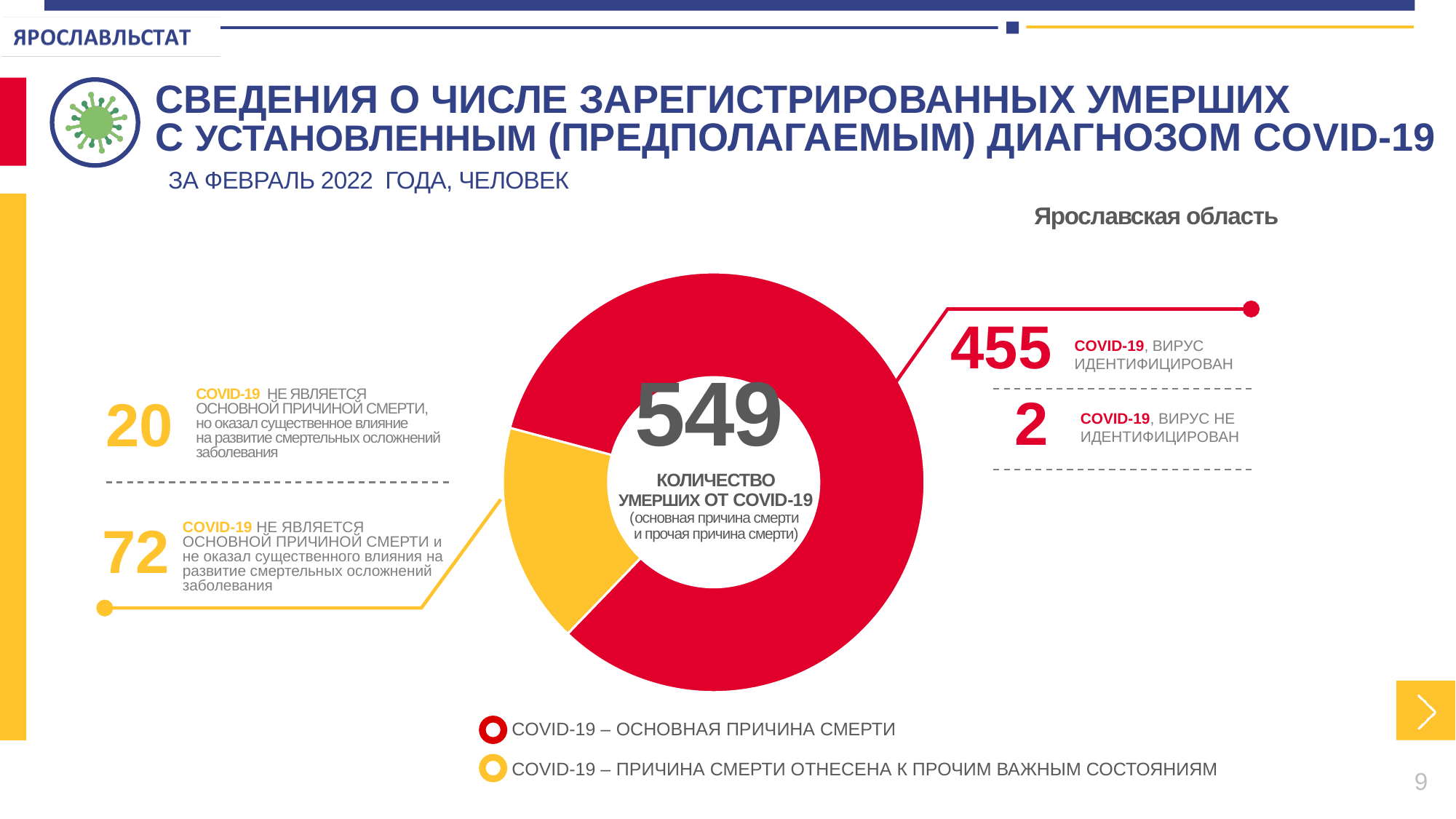
How many deaths are shown for the category "COVID-19, вирус идентифицирован"? 455 What is the total number of deaths from COVID-19 shown in the centre of the donut chart? 549 How many deaths are shown for the category "COVID-19, вирус не идентифицирован"? 2 What is the difference between the value 72 and the value 20 shown for the yellow segment? 52 What type of chart is shown on the slide? Donut (pie) chart What is the difference between the number of deaths with the virus identified (455) and with the virus not identified (2)? 453 Which segment of the donut chart is larger: "COVID-19 – основная причина смерти" (red) or "COVID-19 – причина смерти отнесена к прочим важным состояниям" (yellow)? COVID-19 – основная причина смерти (red) How many categories does the legend of the chart list? 2 How many deaths are shown where COVID-19 was not the main cause of death and did not have a significant influence on the development of fatal complications? 72 What is the combined number of deaths for the red segment (455 + 2)? 457 How many deaths are shown where COVID-19 was not the main cause of death but had a significant influence on the development of fatal complications? 20 Which colour represents "COVID-19 – основная причина смерти" in the chart legend? Red